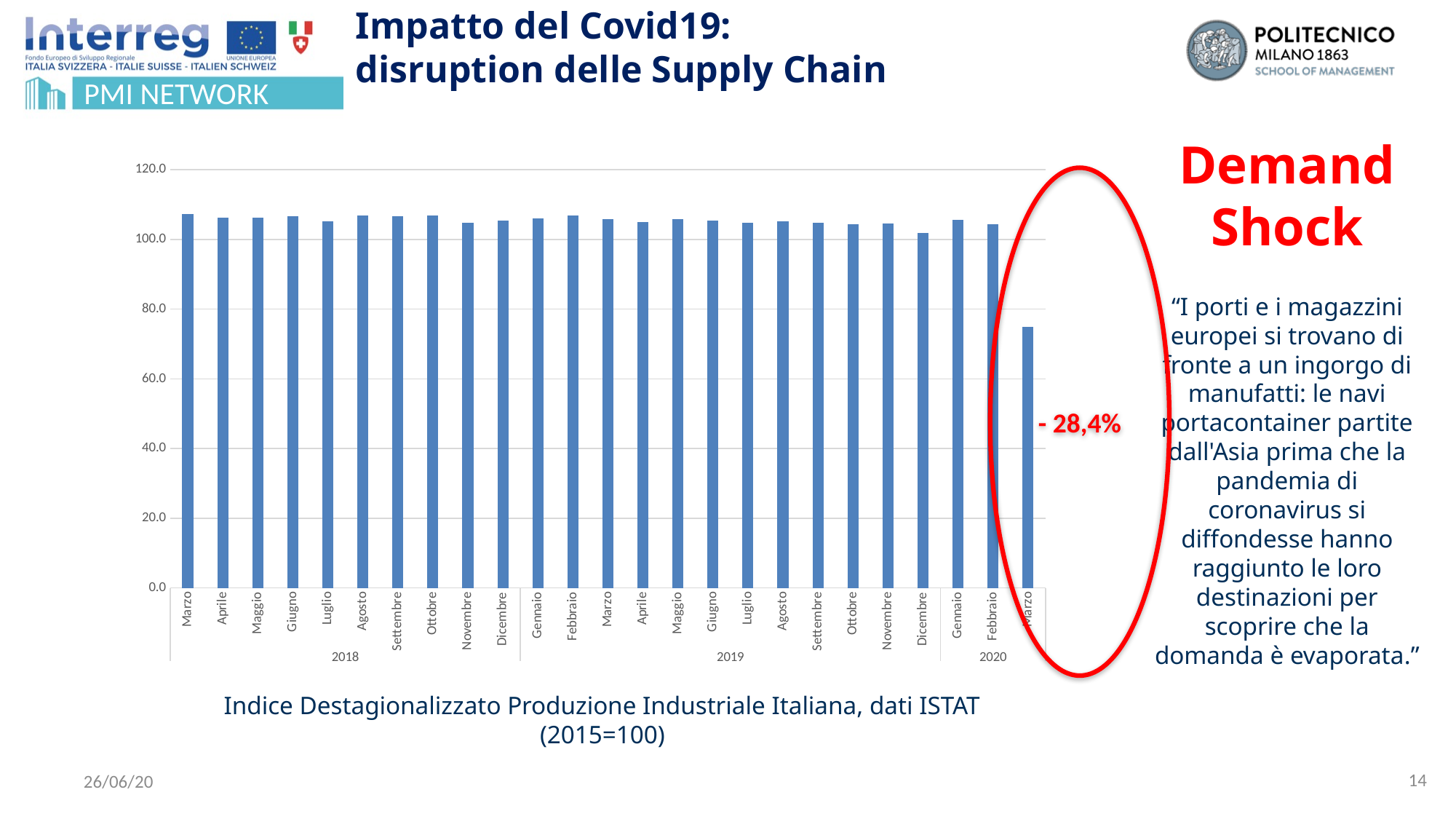
Which is larger, the value for Febbraio 2020 or the value for Marzo 2020? Febbraio 2020 How many years are labelled along the x axis of the chart? 3 Is the value for Marzo 2020 greater or less than 80? less What percentage change is annotated in red next to the Marzo 2020 bar? - 28,4% Is the value for Marzo 2020 greater or less than 60? greater What is the base year of the index according to the caption below the chart? 2015=100 What kind of chart is shown on the slide? bar chart Which is larger, the value for Gennaio 2020 or the value for Marzo 2020? Gennaio 2020 Is the value for Febbraio 2020 greater or less than 100? greater Which month has the lowest value in the chart? Marzo 2020 How many monthly bars are plotted in the chart? 25 Do the values rise or fall between Febbraio 2020 and Marzo 2020? fall